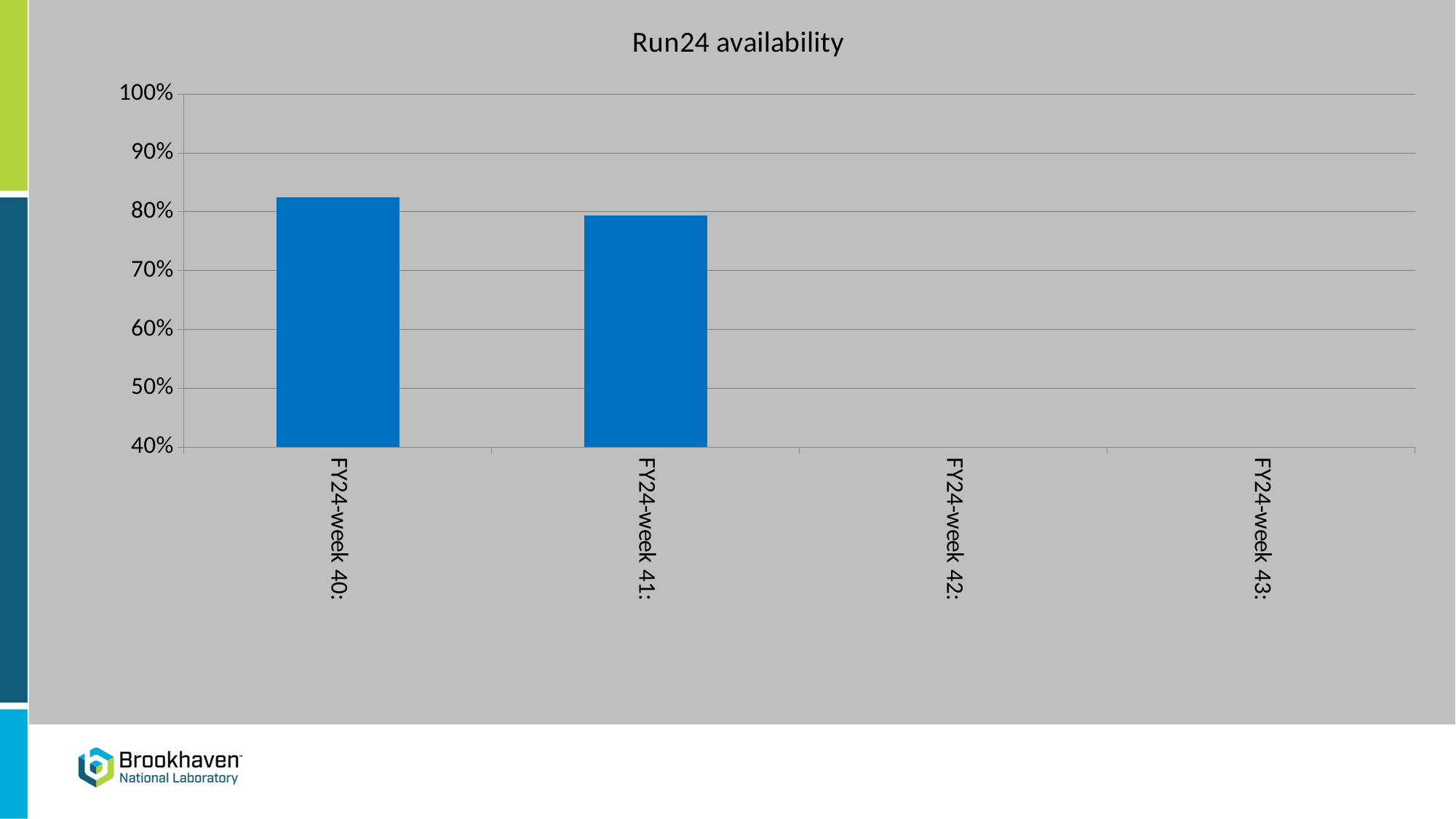
Does the availability rise or fall from FY24-week 40 to FY24-week 41? fall Is the value for FY24-week 40 greater or less than 90%? less Which category has the tallest bar in the chart? FY24-week 40: What kind of chart is shown on the slide? bar chart Which is larger, the value for FY24-week 40 or the value for FY24-week 41? FY24-week 40 How many categories on the x axis have a visible bar plotted? 2 Is the value for FY24-week 41 greater or less than 70%? greater Is the value for FY24-week 40 greater or less than 80%? greater What is the title of the chart? Run24 availability What is the lowest value shown on the y axis of the chart? 40% How many categories are labelled on the x axis of the chart? 4